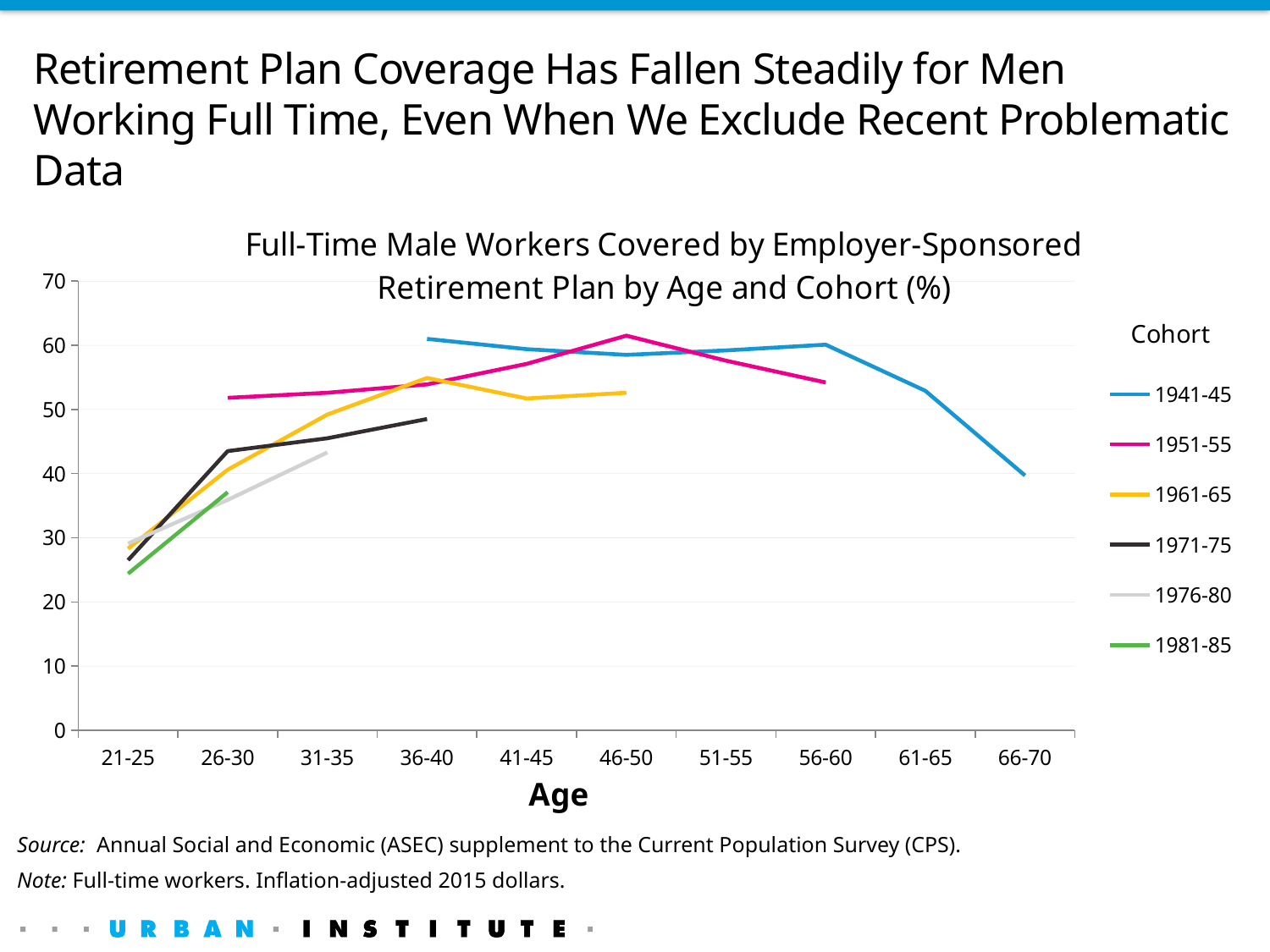
How many age groups are shown on the x axis? 10 What kind of chart is shown on the slide? line chart What is the title of the chart? Full-Time Male Workers Covered by Employer-Sponsored Retirement Plan by Age and Cohort (%) How many cohorts does the legend list? 6 Is the value for the 1981-85 cohort at age 21-25 greater or less than 30? less Is the value for the 1976-80 cohort at age 31-35 greater or less than 40? greater Is the value for the 1941-45 cohort at age 61-65 greater or less than 50? greater At age 26-30, which cohort has the higher value: 1951-55 or 1971-75? 1951-55 Does the 1941-45 cohort line rise or fall from age 56-60 to age 66-70? fall At age 36-40, which cohort has the higher value: 1941-45 or 1971-75? 1941-45 Which cohort has the highest value at age 46-50? 1951-55